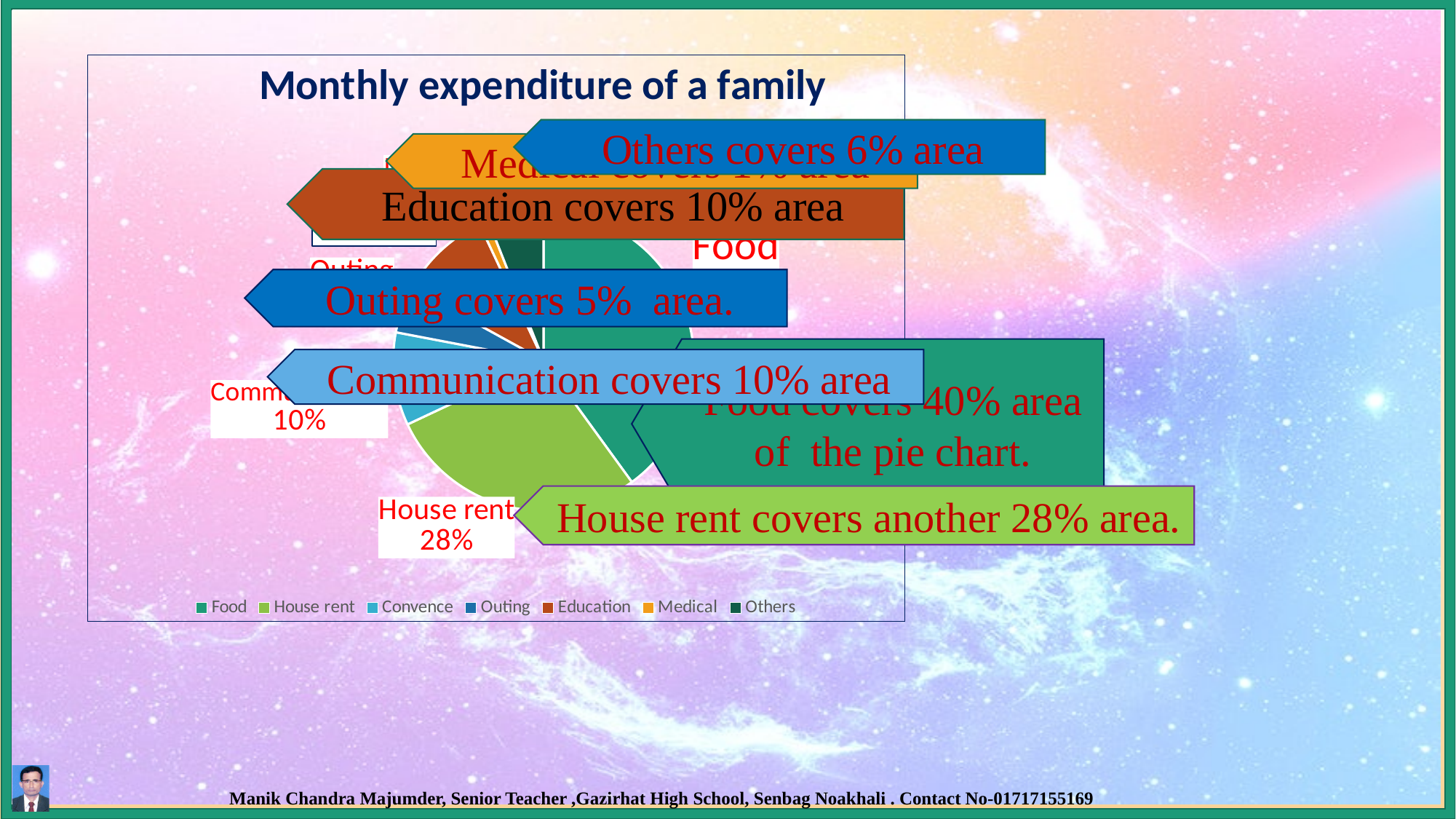
Which category covers the largest share of the pie chart? Food What percentage of the pie chart does Education cover? 10% What is the title of the chart? Monthly expenditure of a family What percentage of the pie chart does Others cover? 6% What share of the pie chart does Food cover? 40% What percentage of the pie chart does Outing cover? 5% Which covers a larger share of the pie chart, Food or House rent? Food What percentage of the pie chart does Communication cover? 10% What share of the pie chart does House rent cover? 28% By how many percentage points does Food's share exceed House rent's share? 12% What kind of chart is shown on the slide? pie chart How many categories does the legend of the pie chart list? 7